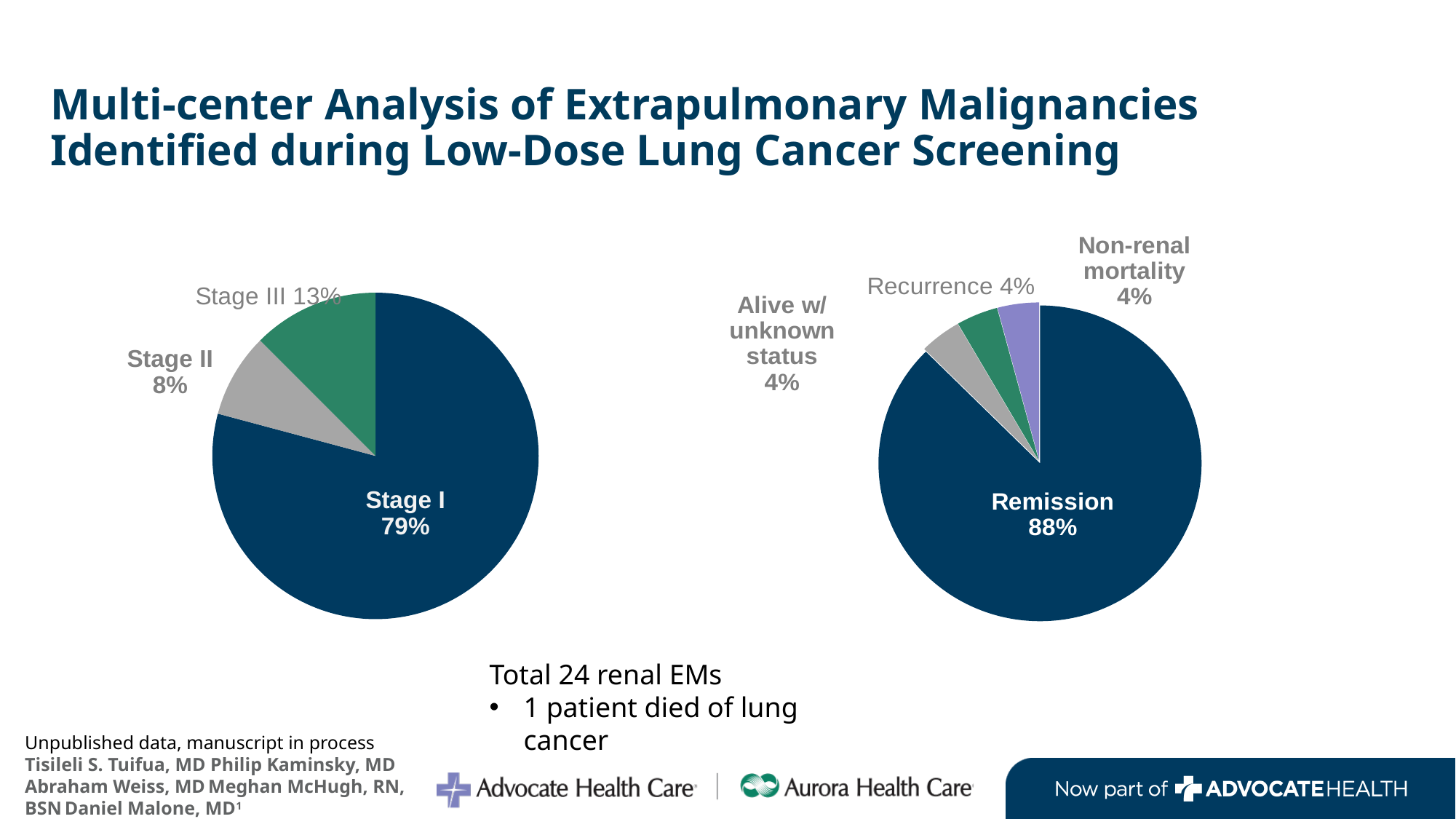
In the right pie chart, what share is labelled Non-renal mortality? 4% In the right pie chart, which slice is the largest? Remission In the left pie chart, how many slices are there? 3 What kind of chart is the right chart? Pie chart In the right pie chart, how many slices are there? 4 In the left pie chart, which slice is the smallest? Stage II In the left pie chart, what share is labelled Stage I? 79% In the left pie chart, what is the difference between the Stage III and Stage II shares? 5% In the left pie chart, which slice is the largest? Stage I In the left pie chart, what share is labelled Stage II? 8% In the left pie chart, what share is labelled Stage III? 13% In the right pie chart, what share is labelled Remission? 88%